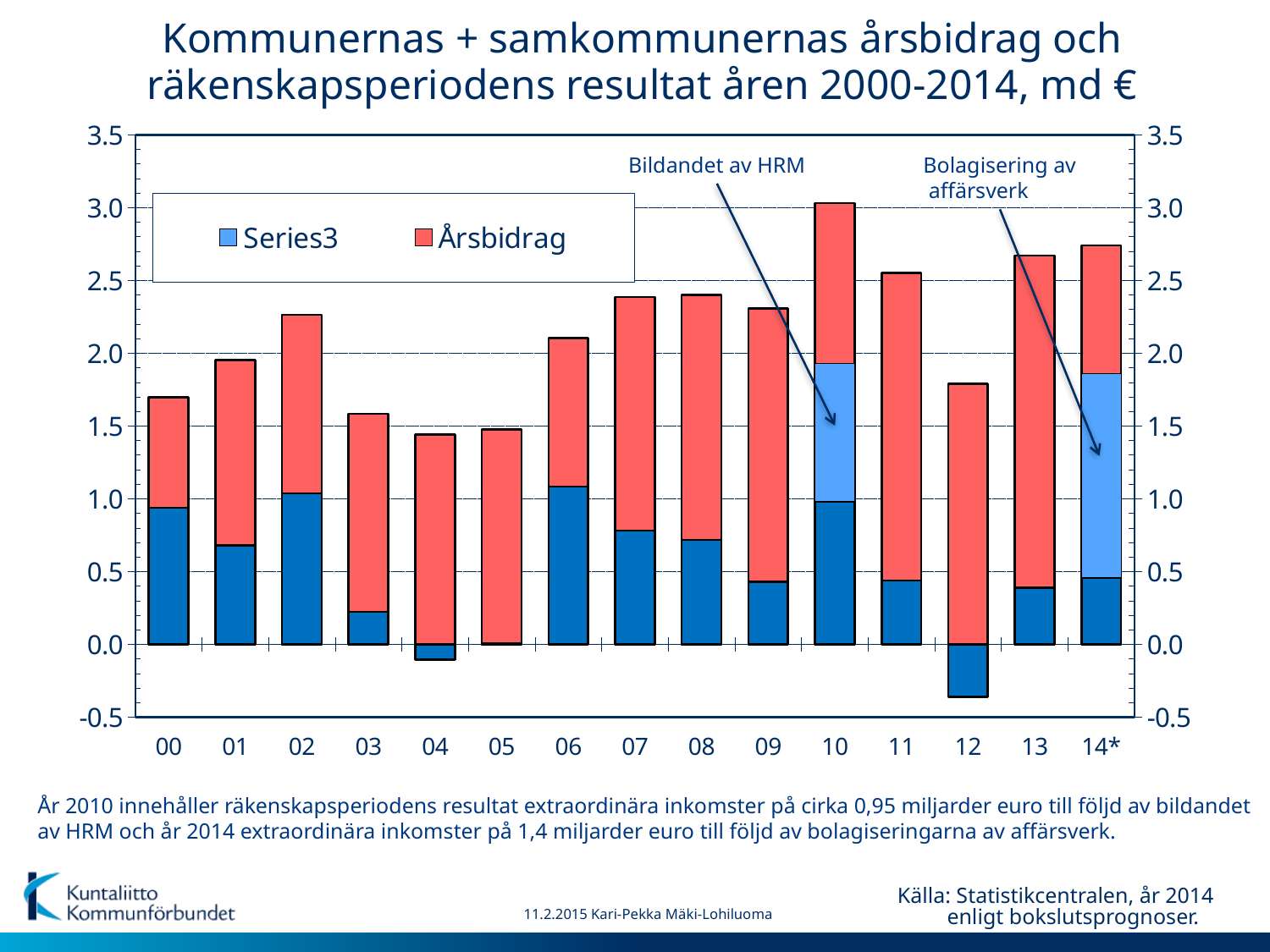
Is the top of the stacked bar for year 08 greater or less than 2.5? less Which year has the taller stacked bar, 10 or 11? 10 Is the top of the stacked bar for year 10 greater or less than 2.5? greater How many years (categories) are shown on the x axis of the chart? 15 What are the two series named in the legend? Series3 and Årsbidrag Which year has the tallest stacked bar (highest top of the Årsbidrag segment)? 10 Which year has the lowest Series3 value? 12 What kind of chart is shown on the slide? Stacked bar chart Is the top of the stacked bar for year 13 greater or less than 2.5? greater Do the stacked bar totals rise or fall from year 02 to year 04? fall How many series does the chart legend list? 2